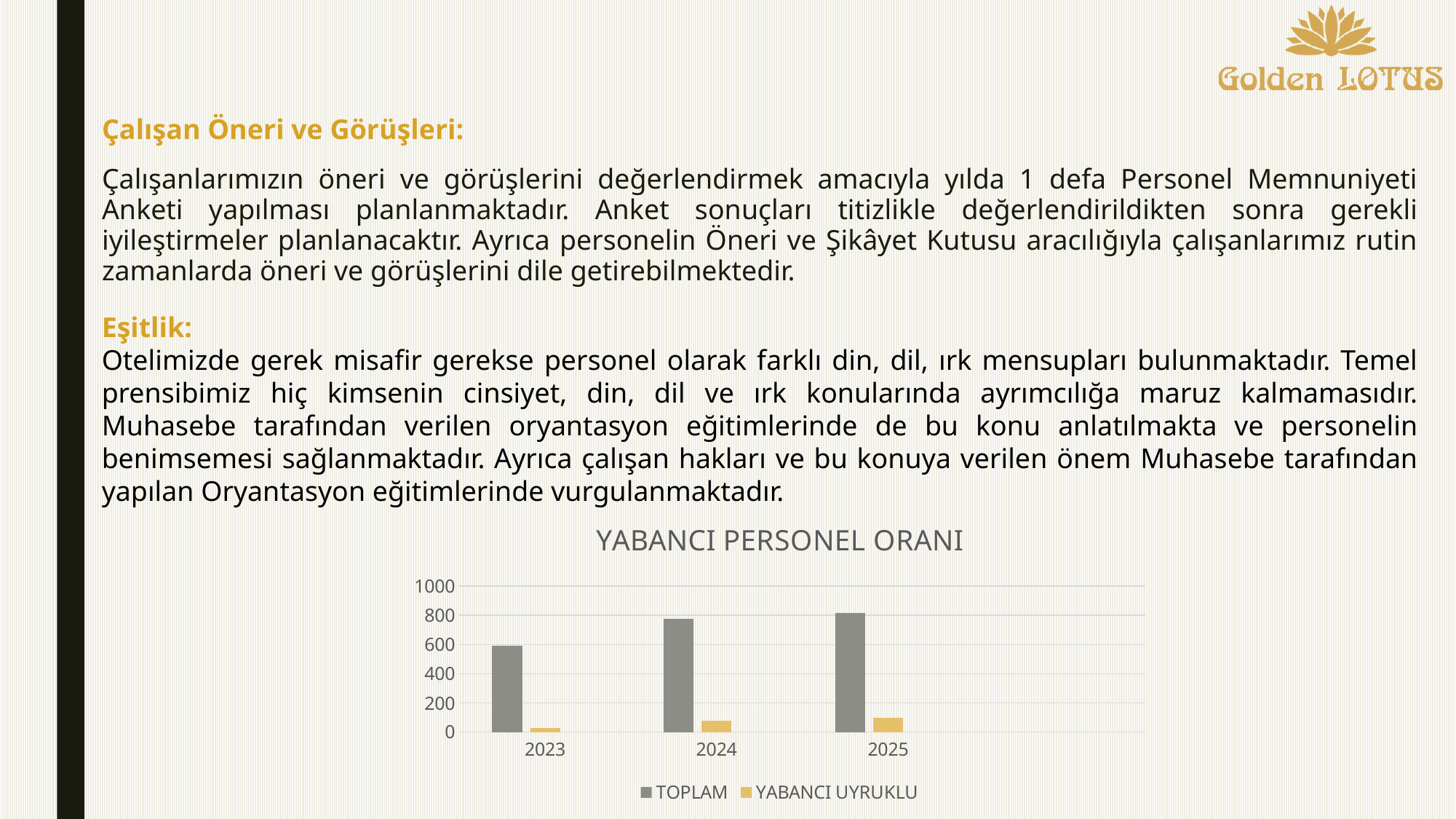
Is the TOPLAM value for 2024 greater or less than 600? greater Which is larger, the TOPLAM value for 2023 or the TOPLAM value for 2024? 2024 Is the TOPLAM value for 2023 greater or less than 400? greater How many series does the chart legend list? 2 How many years are shown on the x axis of the chart? 3 In which year is the YABANCI UYRUKLU value lowest? 2023 Which series is shown in gold in the chart? YABANCI UYRUKLU Is the YABANCI UYRUKLU value for 2025 greater or less than 200? less In which year is the TOPLAM value lowest? 2023 Do the TOPLAM values rise or fall from 2023 to 2025? rise What is the title of the chart on the slide? YABANCI PERSONEL ORANI What type of chart is shown under the title YABANCI PERSONEL ORANI? bar chart